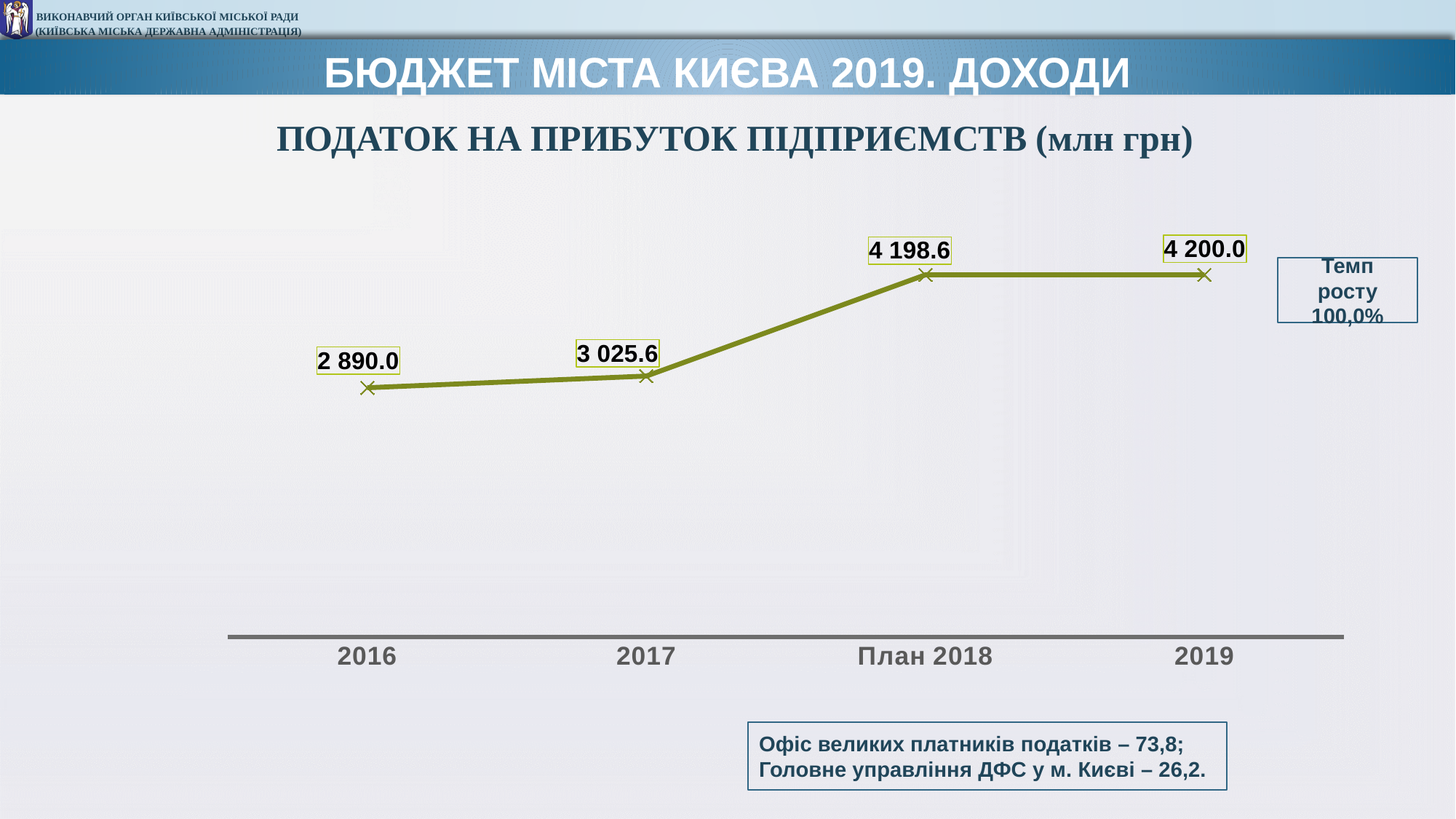
What is the value for 2017 on the chart? 3 025.6 What is the value for План 2018 on the chart? 4 198.6 What is the difference between the values for План 2018 and 2017? 1 173.0 How many data points are plotted on the chart? 4 What kind of chart is shown on the slide? Line chart What is the difference between the values for 2019 and План 2018? 1.4 What is the value for 2019 on the chart? 4 200.0 Which category has the lowest value on the chart? 2016 What is the value for 2016 on the chart? 2 890.0 Which is larger, the value for 2017 or the value for 2016? 2017 What is the difference between the values for 2017 and 2016? 135.6 Do the values rise or fall from 2016 to 2019 along the x axis? Rise